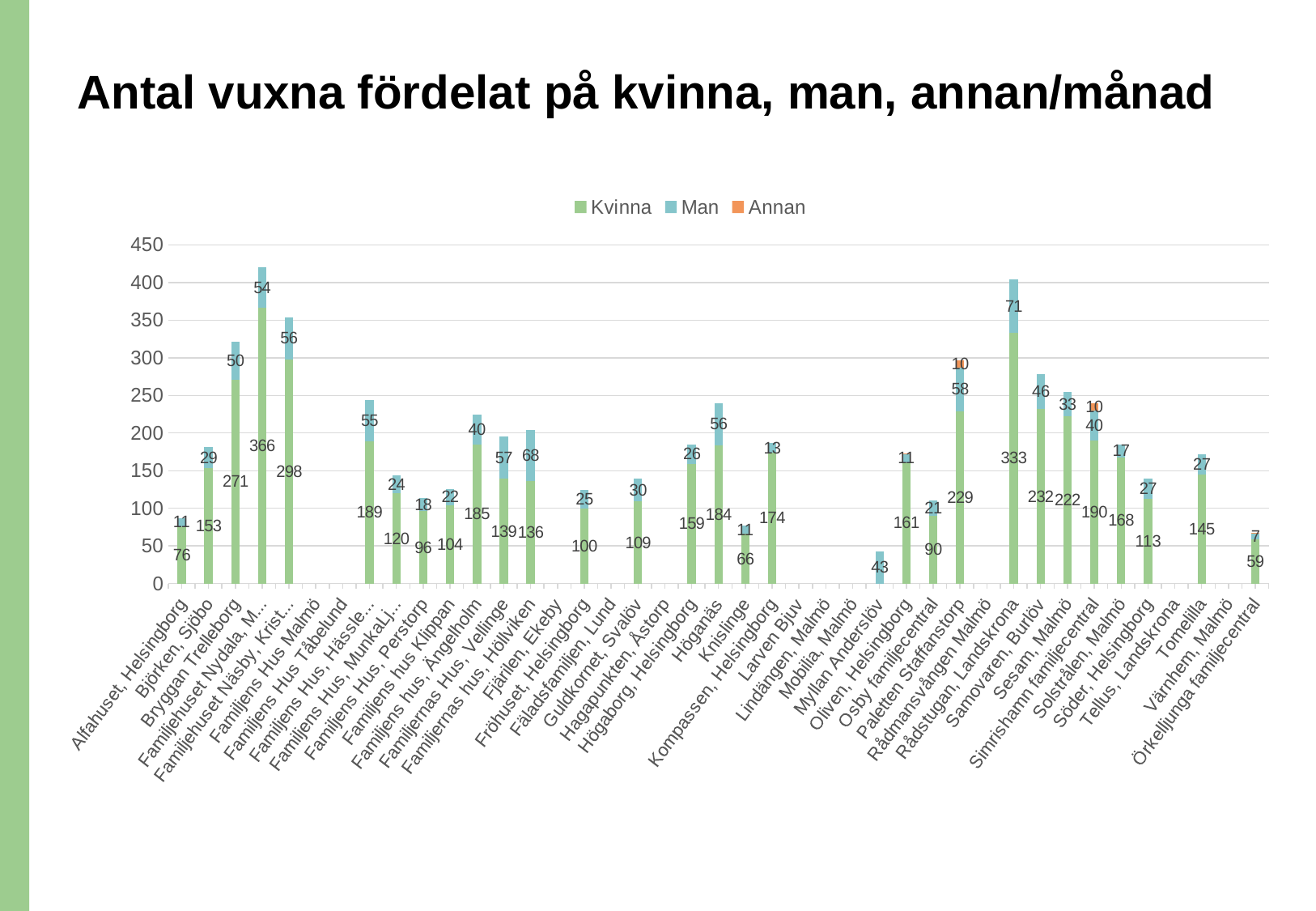
Which has a larger Man value, Familjernas hus, Höllviken or Familjens hus, Ängelholm? Familjernas hus, Höllviken What kind of chart is shown on the slide? Stacked bar chart What is the total of the stacked bar for Björken, Sjöbo? 182 How many series does the legend list? 3 Is the total stacked value for Rådstugan, Landskrona greater or less than 350? greater What is the Kvinna value for Bryggan Trelleborg? 271 What is the Man value for Rådstugan, Landskrona? 71 What is the difference between the Kvinna values for Höganäs and Knislinge? 118 What is the title of the chart? Antal vuxna fördelat på kvinna, man, annan/månad Which category has the highest Kvinna value? Familjehuset Nydala, M... What is the Annan value for Paletten Staffanstorp? 10 What is the Kvinna value for Tomelilla? 145